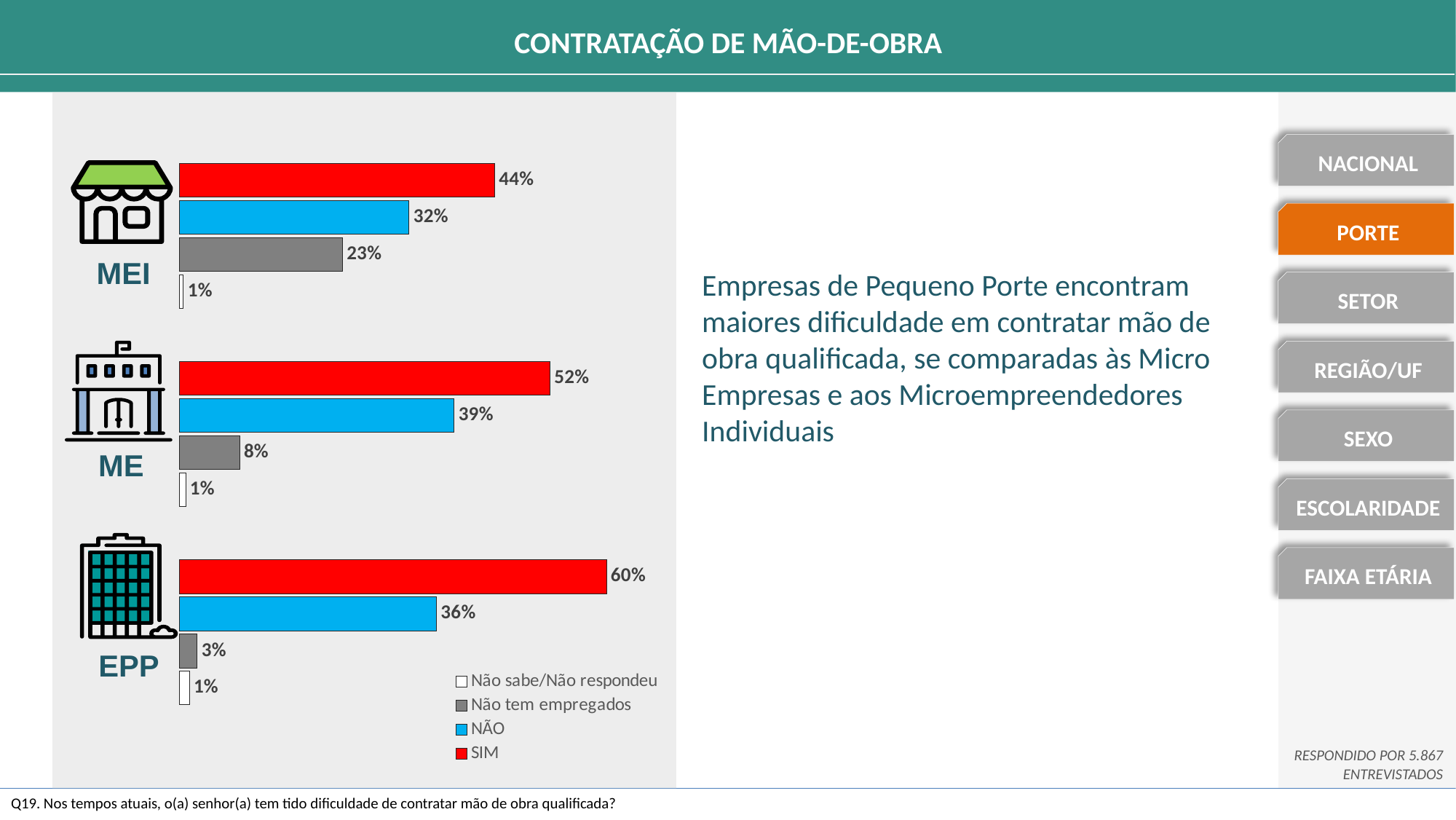
What percentage of EPP respondents answered SIM? 60% Which is larger for ME: the SIM value or the NÃO value? SIM What percentage of MEI respondents answered Não tem empregados? 23% Which category has the lowest Não tem empregados value? EPP How many series does the legend list? 4 What is the value of the NÃO bar for ME? 39% Which category has the highest SIM value? EPP How many categories (company sizes) are shown in the chart? 3 What is the Não sabe/Não respondeu value for EPP? 1% What kind of chart is shown on the slide? Bar chart Which colour represents the SIM series in the legend? Red What is the difference between the SIM values for EPP and MEI? 16 percentage points